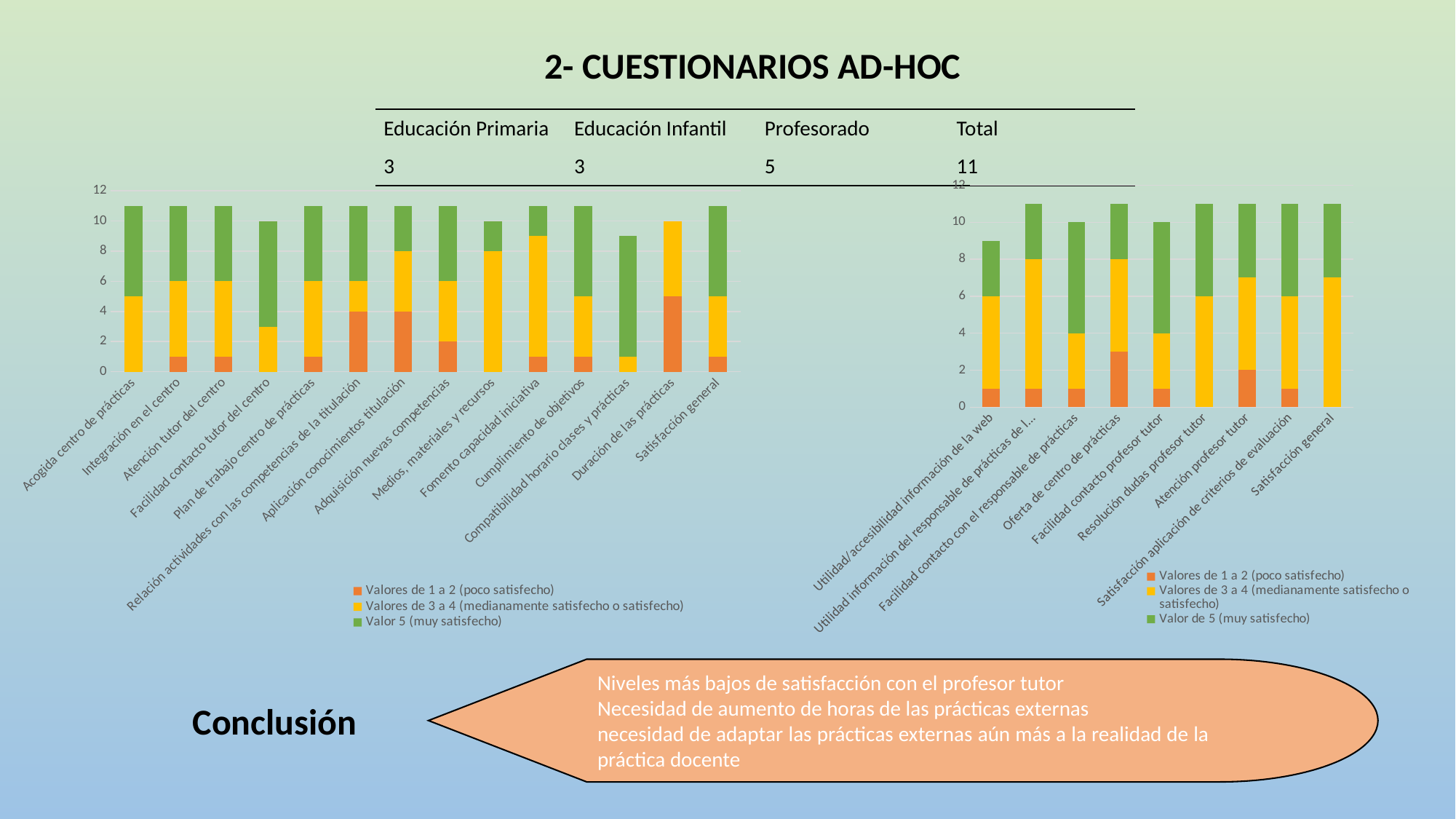
In the right chart, is the 'Valores de 1 a 2 (poco satisfecho)' segment for 'Oferta de centro de prácticas' greater or less than 2? greater What is the title shown above the charts on the slide? 2- CUESTIONARIOS AD-HOC In the left chart, which category has the larger 'Valor 5 (muy satisfecho)' segment: 'Compatibilidad horario clases y prácticas' or 'Duración de las prácticas'? Compatibilidad horario clases y prácticas How many categories does the left chart show along its x axis? 14 Which colour represents 'Valor 5 (muy satisfecho)' in the left chart? Green How many series does the legend of the left chart list? 3 In the left chart, is the total bar height for 'Compatibilidad horario clases y prácticas' greater or less than 10? less How many categories does the right chart show along its x axis? 9 What kind of chart is the left chart on the slide? Stacked bar chart In the left chart, is the total bar height for 'Duración de las prácticas' greater or less than 8? greater How many series does the legend of the right chart list? 3